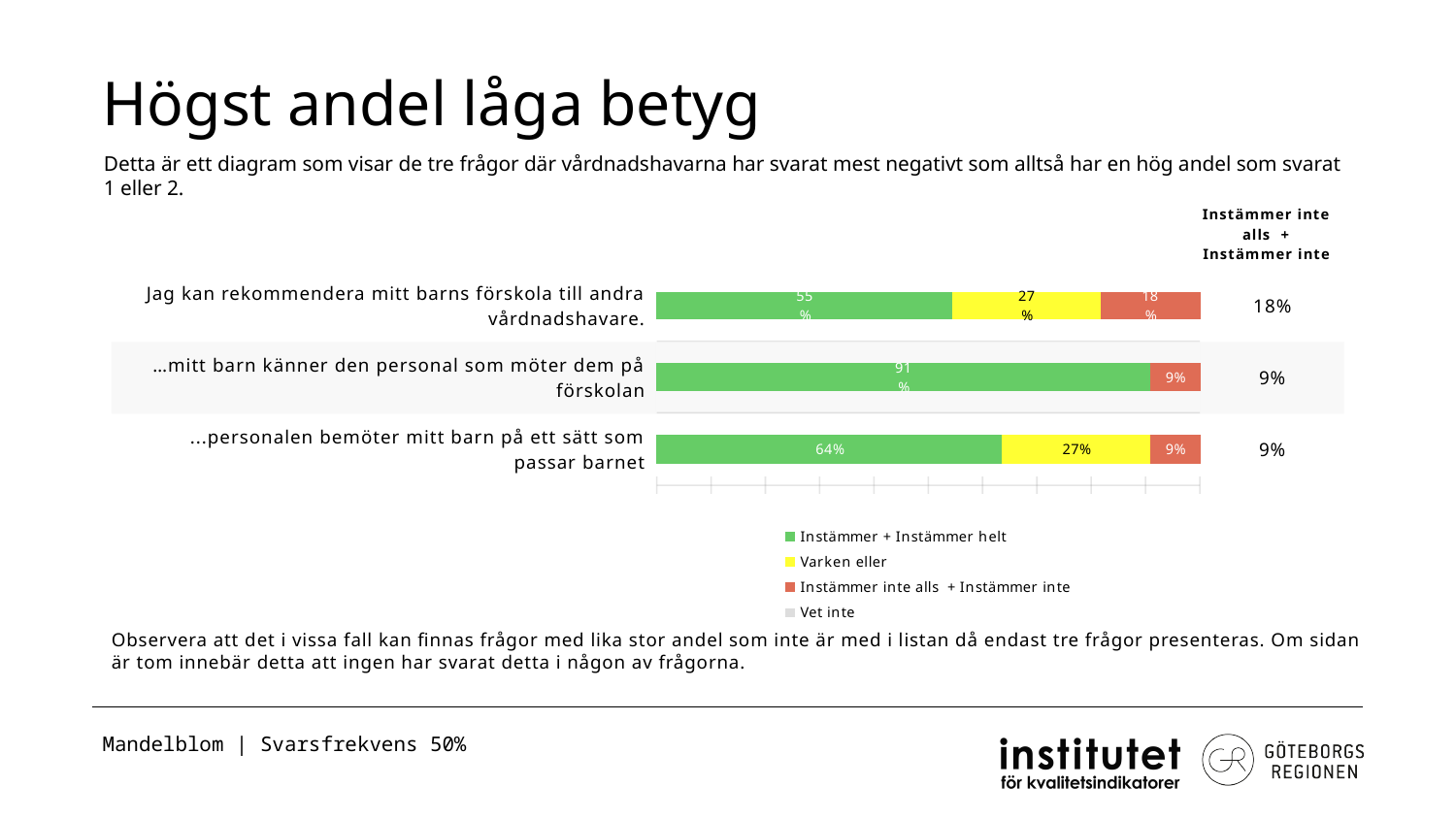
What kind of chart is shown on the slide? Stacked bar chart How many questions (categories) are plotted in the chart? 3 What colour represents 'Varken eller' in the chart? Yellow Which is larger: the 'Instämmer + Instämmer helt' value for '...personalen bemöter mitt barn på ett sätt som passar barnet' or for 'Jag kan rekommendera mitt barns förskola till andra vårdnadshavare.'? ...personalen bemöter mitt barn på ett sätt som passar barnet What is the 'Instämmer inte alls + Instämmer inte' value for 'Jag kan rekommendera mitt barns förskola till andra vårdnadshavare.'? 18% What is the 'Varken eller' value for '...personalen bemöter mitt barn på ett sätt som passar barnet'? 27% What is the 'Instämmer + Instämmer helt' value for '…mitt barn känner den personal som möter dem på förskolan'? 91% Which question has the highest 'Instämmer inte alls + Instämmer inte' share? Jag kan rekommendera mitt barns förskola till andra vårdnadshavare. What is the total of the stacked bar for 'Jag kan rekommendera mitt barns förskola till andra vårdnadshavare.'? 100% Which question has the highest 'Instämmer + Instämmer helt' share? …mitt barn känner den personal som möter dem på förskolan How many series does the legend list? 4 What is the difference between the 'Instämmer + Instämmer helt' values for '…mitt barn känner den personal som möter dem på förskolan' and 'Jag kan rekommendera mitt barns förskola till andra vårdnadshavare.'? 36 percentage points